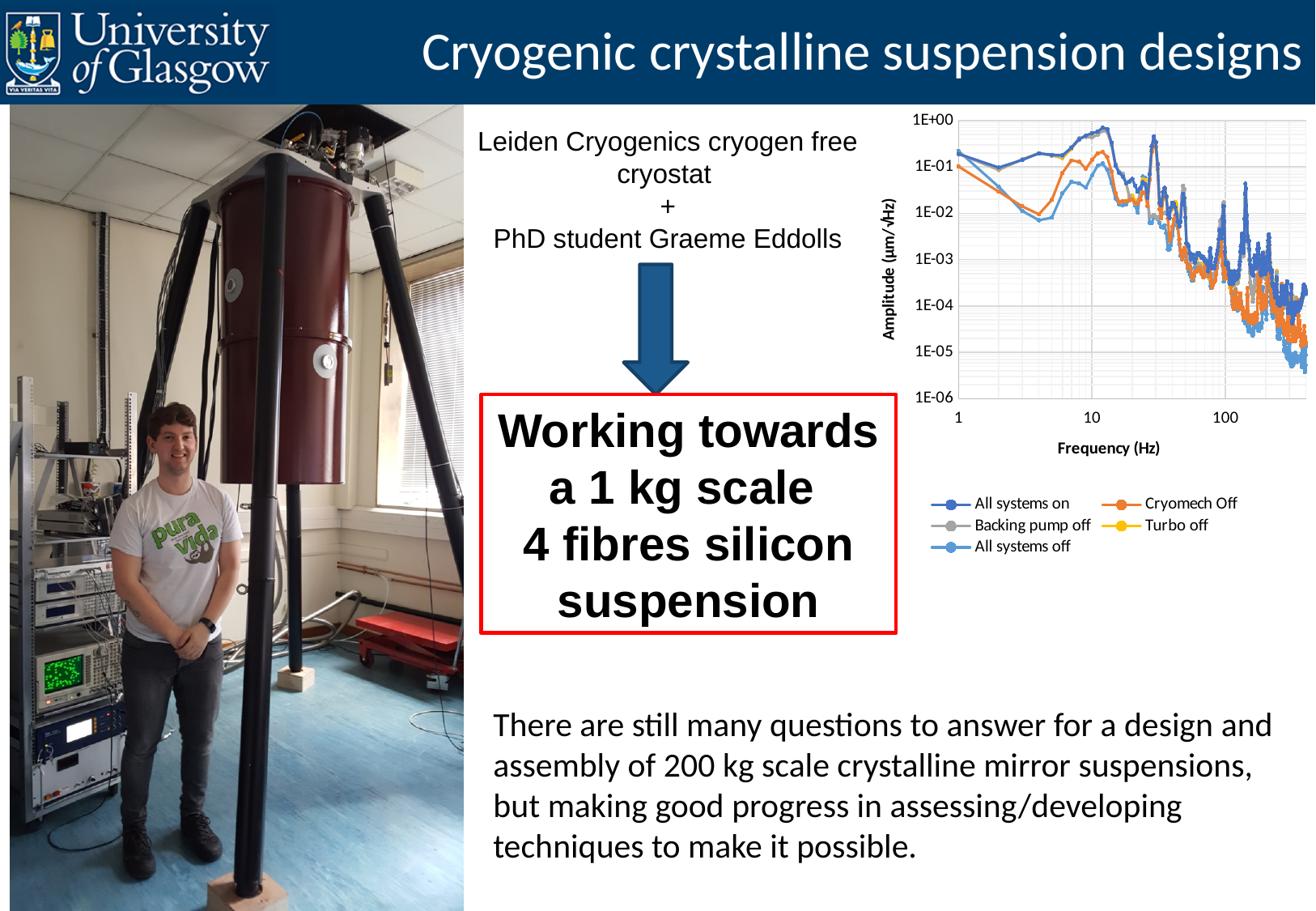
Overall, does the amplitude rise or fall as frequency increases beyond about 10 Hz? fall Is the amplitude for 'All systems off' at around 4 Hz greater or less than 1E-02? less How many series does the chart's legend list? 5 Is the peak amplitude of 'All systems on' near 10 Hz greater or less than 1E+00? less What is the lowest value shown on the y axis of the chart? 1E-06 What is the label of the y axis of the chart? Amplitude (µm/√Hz) Is the amplitude for 'All systems on' at 1 Hz greater or less than 1E-01? greater Which series reaches the lowest amplitude at the high-frequency end of the chart? All systems off What kind of chart is shown on the slide? line chart Which series in the chart is drawn in orange? Cryomech Off